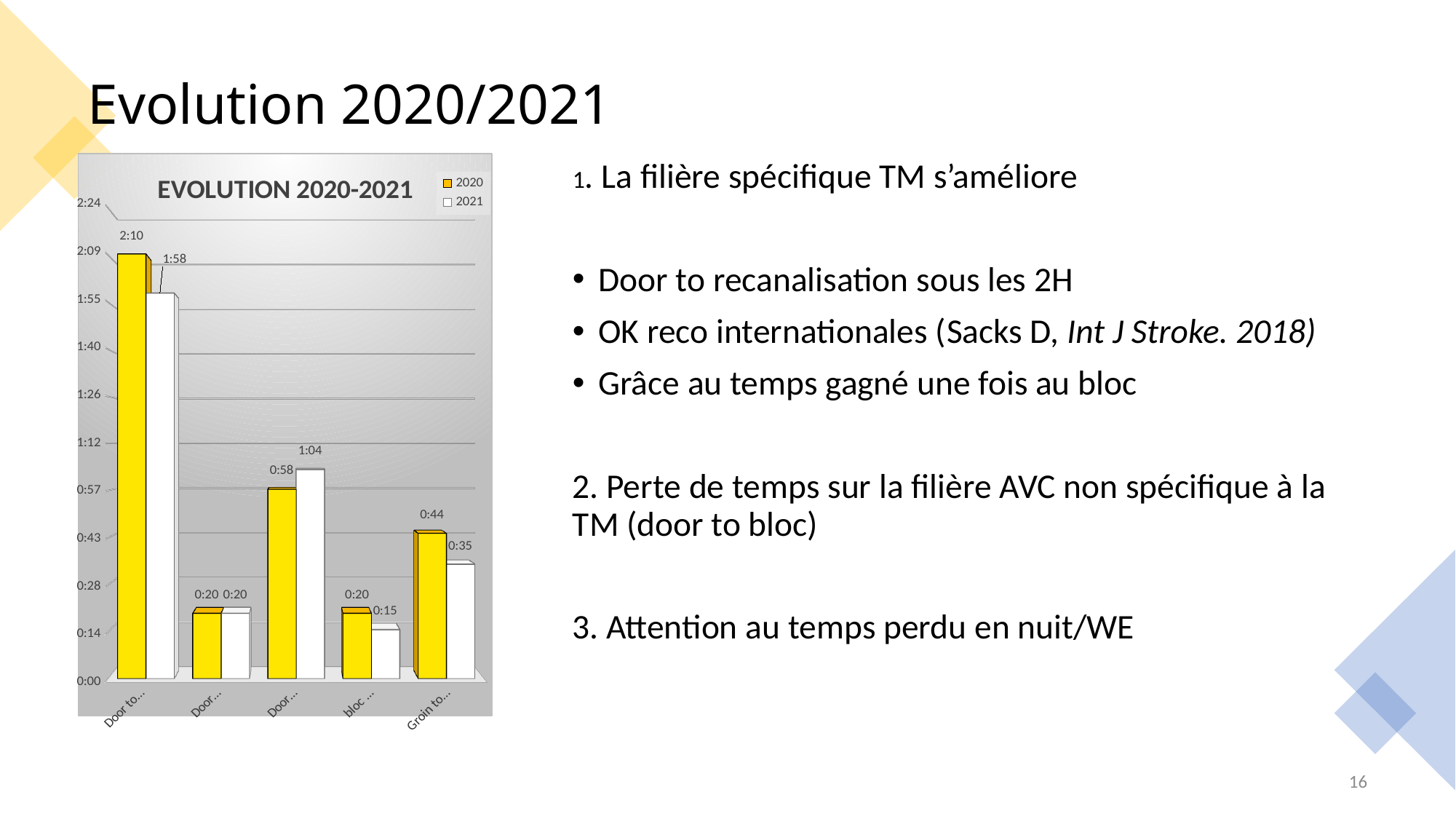
How many categories are plotted along the x axis of the chart? 5 What is the 2021 value for the first category (Door to...) in the chart? 1:58 What is the 2021 value for the last category (Groin to...) in the chart? 0:35 How many series does the legend of the EVOLUTION 2020-2021 chart list? 2 By how much did the value for the first category (Door to...) decrease from 2020 (2:10) to 2021 (1:58)? 12 minutes What is the highest value in the 2020 series? 2:10 What is the 2020 value for the first category (Door to...) in the chart? 2:10 Which colour represents the 2020 series in the chart? Yellow What kind of chart is shown on the slide? Bar chart What is the 2020 value for the last category (Groin to...) in the chart? 0:44 For the third category, which series has the larger value, 2020 or 2021? 2021 What is the lowest value in the 2021 series? 0:15